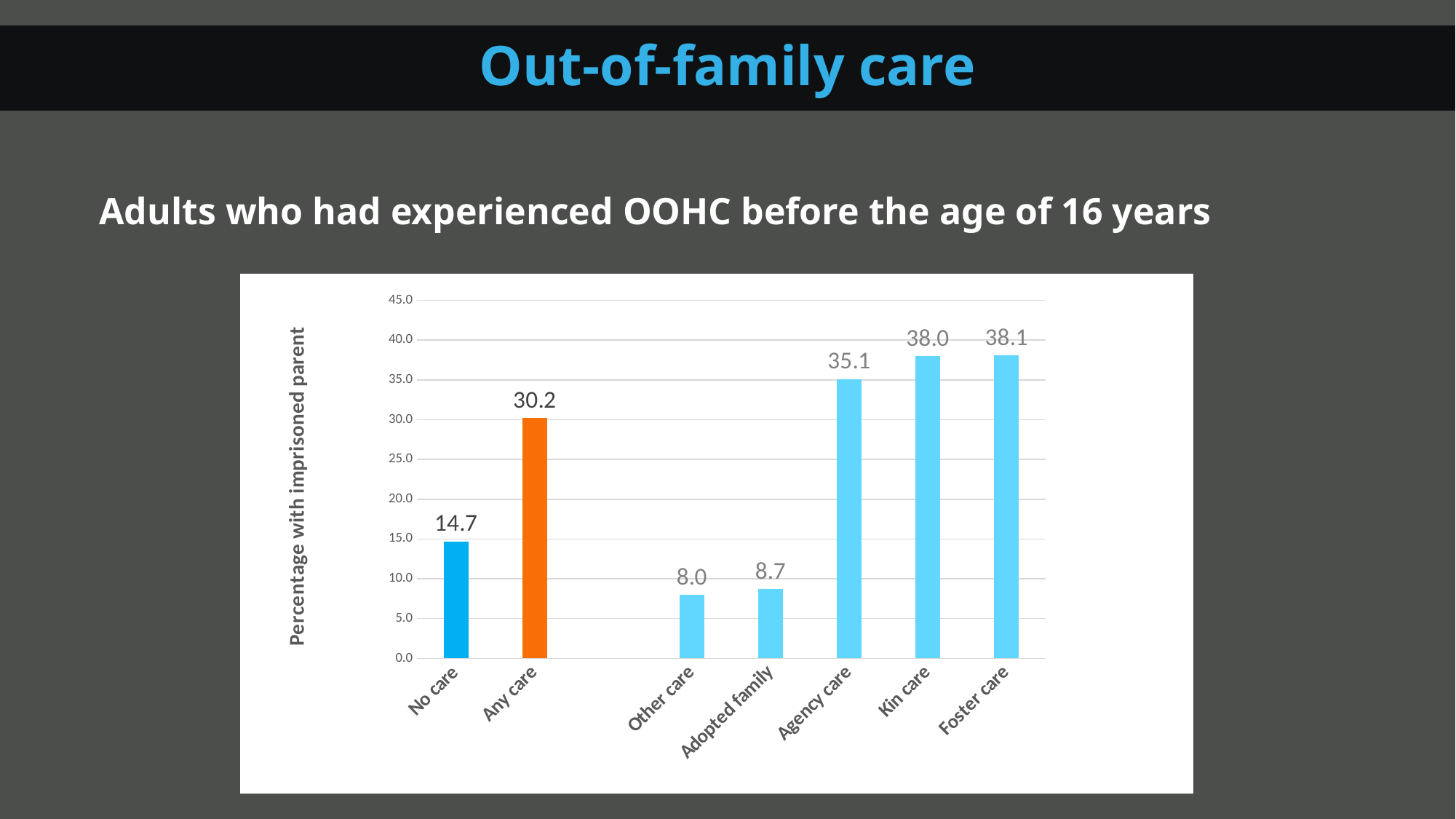
Which category has the lowest value? Other care Which category has the highest value? Foster care What is the value for Agency care? 35.1 What is the difference between the values for Kin care and Agency care? 2.9 What is the value for Any care? 30.2 How many categories are shown on the x axis? 7 What kind of chart is shown on the slide? Bar chart Which is larger, the value for Agency care or the value for Any care? Agency care What is the value for Adopted family? 8.7 What is the difference between the values for Any care and No care? 15.5 What is the label on the vertical axis of the chart? Percentage with imprisoned parent What is the value for No care? 14.7